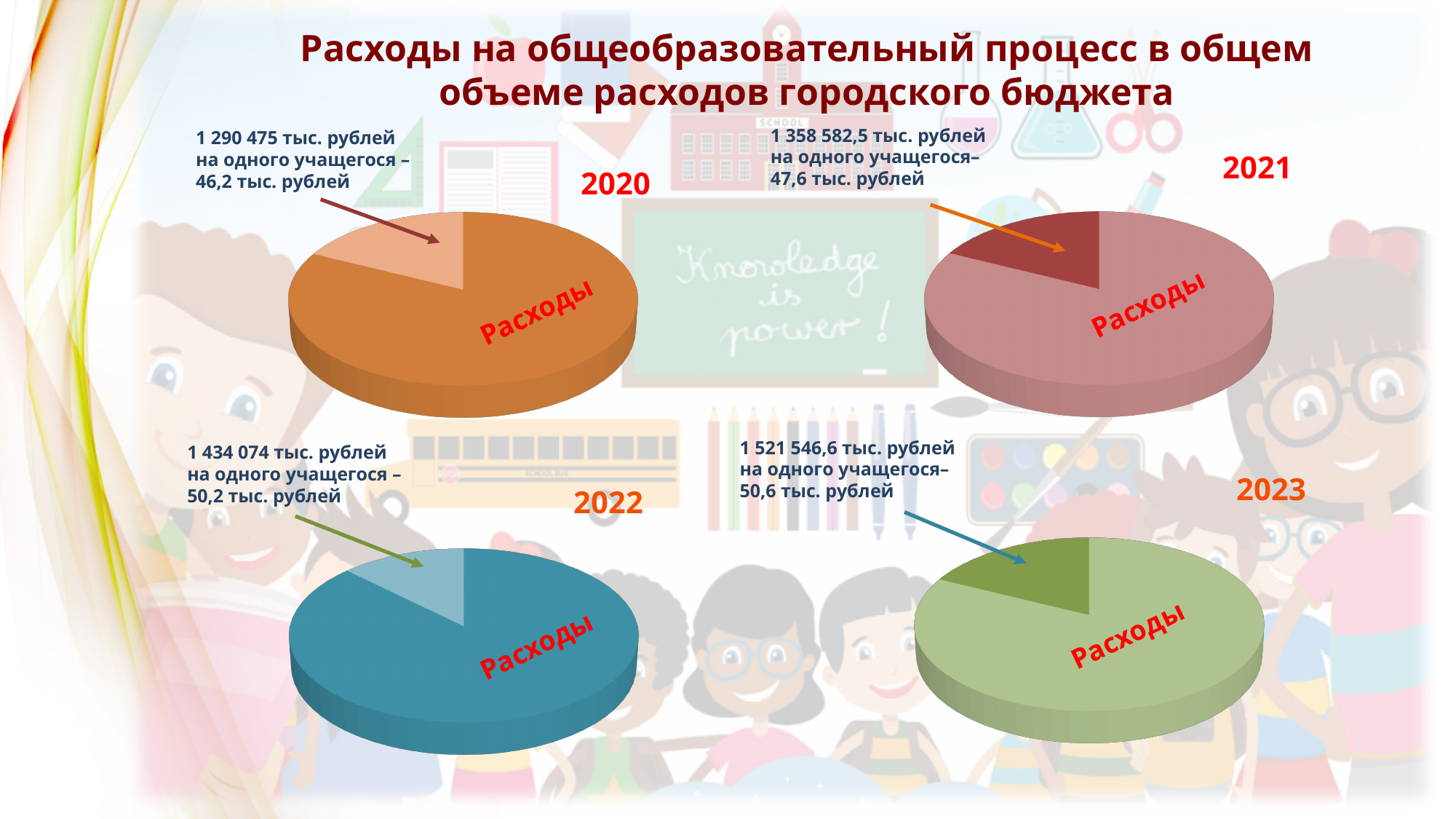
How many pie charts are shown on the slide? 4 In the 2020 pie chart, what amount in thousand rubles is indicated for the smaller slice? 1 290 475 тыс. рублей According to the 2020 pie chart annotation, what is the spending per student? 46,2 тыс. рублей In the 2022 pie chart, what amount in thousand rubles is indicated for the smaller slice? 1 434 074 тыс. рублей In the 2022 pie chart, which slice is larger: the slice labelled 'Расходы' or the slice annotated with 1 434 074 тыс. рублей? Расходы In the 2021 pie chart, what amount in thousand rubles is indicated for the smaller slice? 1 358 582,5 тыс. рублей Across the four pie charts, which year has the lowest annotated spending per student? 2020 Do the annotated spending amounts rise or fall from the 2020 pie chart to the 2023 pie chart? Rise In the 2023 pie chart, what amount in thousand rubles is indicated for the smaller slice? 1 521 546,6 тыс. рублей According to the 2023 pie chart annotation, what is the spending per student? 50,6 тыс. рублей Across the four pie charts, which year has the highest annotated spending on the educational process? 2023 What kind of chart is used for the 2020 data on the slide? Pie chart